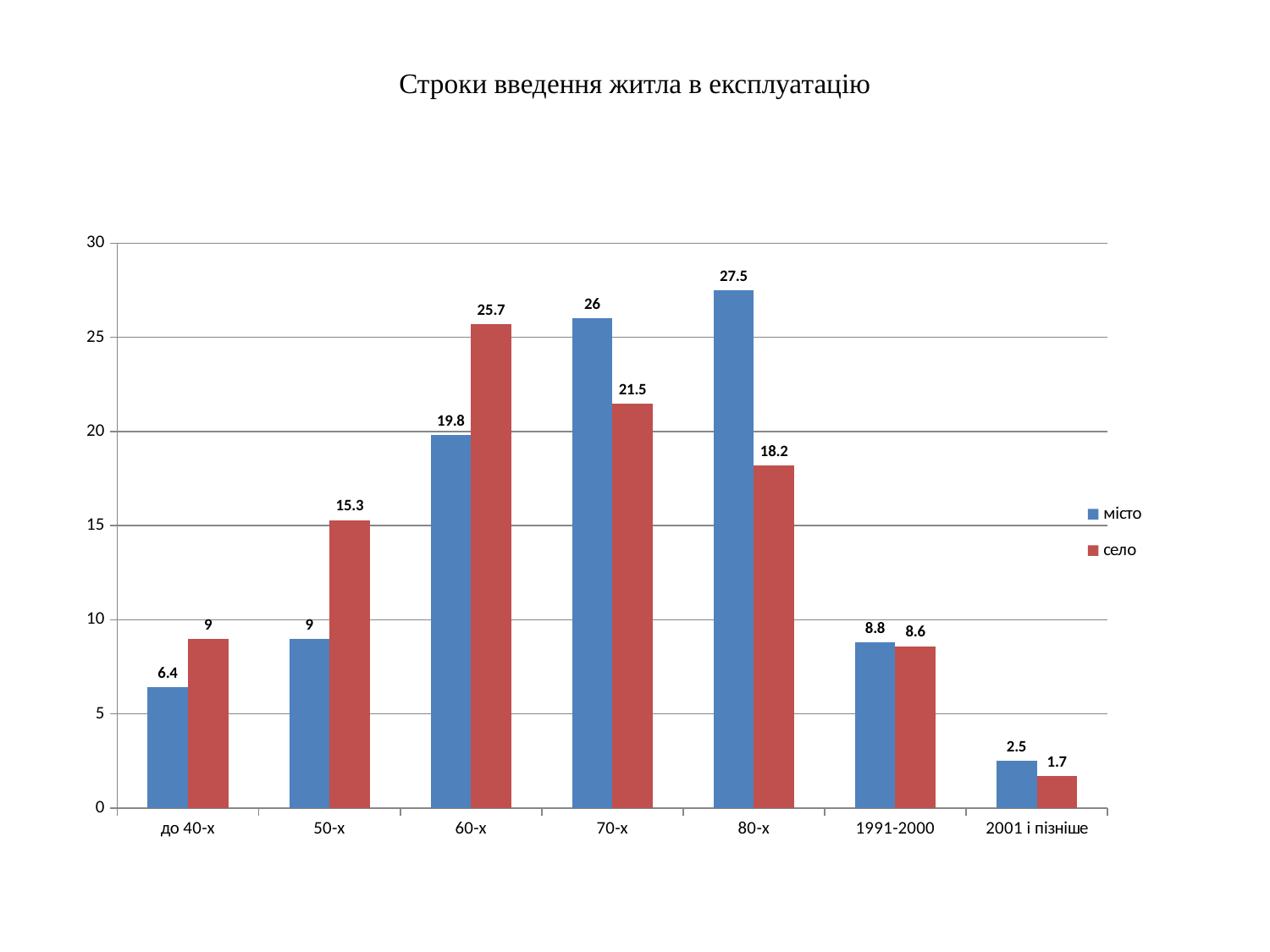
What is the value for село in the 2001 і пізніше category? 1.7 What is the title of the chart? Строки введення житла в експлуатацію In the 60-х category, which series has the larger value, місто or село? село What is the value for місто in the 80-х category? 27.5 How many series does the legend list? 2 What is the value for село in the 50-х category? 15.3 What is the difference between місто and село in the 80-х category? 9.3 How many categories are shown on the x axis? 7 What kind of chart is shown on the slide? bar chart Which category has the highest value for місто? 80-х Which category has the lowest value for село? 2001 і пізніше Do the values for місто rise or fall from 80-х to 2001 і пізніше? fall